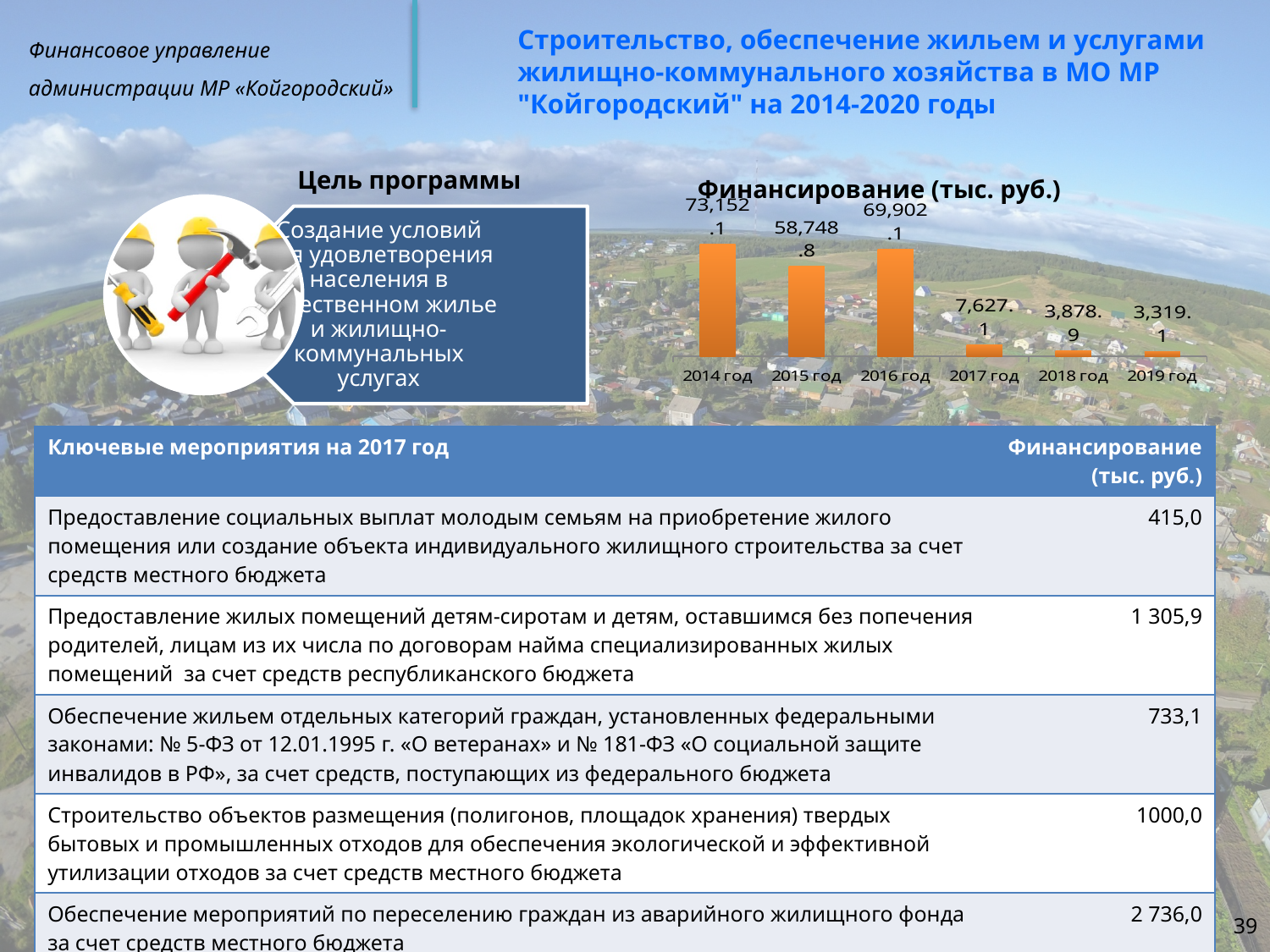
How many years are shown in the Финансирование (тыс. руб.) chart? 6 Which year has the highest value in the Финансирование (тыс. руб.) chart? 2014 год What is the value for 2017 год in the Финансирование (тыс. руб.) chart? 7,627.1 What type of chart is the Финансирование (тыс. руб.) chart? Bar chart What is the difference between the values for 2017 год and 2018 год in the Финансирование (тыс. руб.) chart? 3,748.2 What is the title of the chart on the slide? Финансирование (тыс. руб.) Which is larger in the Финансирование (тыс. руб.) chart: the value for 2015 год or 2016 год? 2016 год What is the value for 2014 год in the Финансирование (тыс. руб.) chart? 73,152.1 Which year has the lowest value in the Финансирование (тыс. руб.) chart? 2019 год What is the difference between the values for 2014 год and 2015 год in the Финансирование (тыс. руб.) chart? 14,403.3 Do the values in the Финансирование (тыс. руб.) chart generally rise or fall from 2016 год to 2019 год? Fall What is the value for 2019 год in the Финансирование (тыс. руб.) chart? 3,319.1